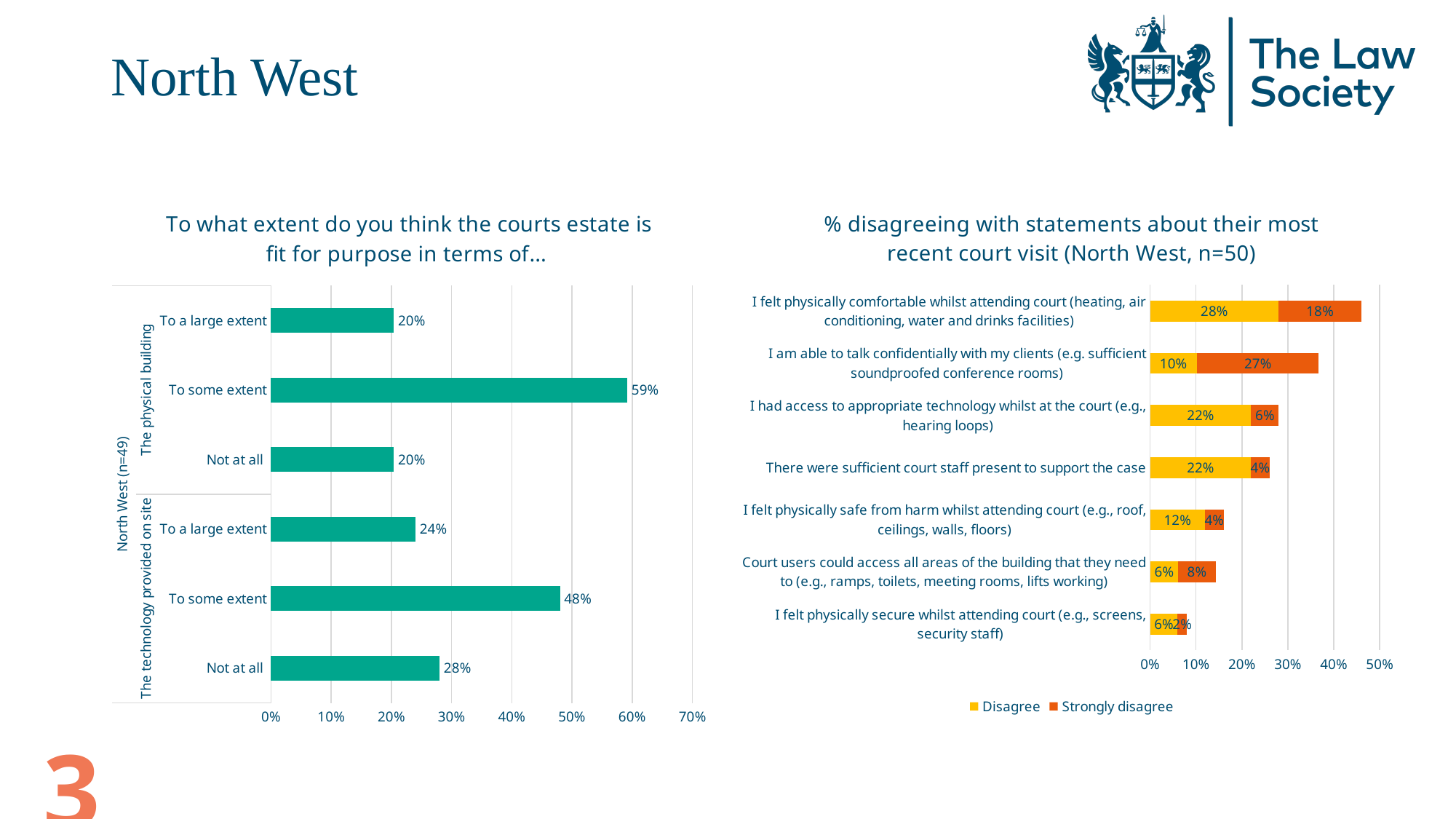
In the left chart 'To what extent do you think the courts estate is fit for purpose in terms of...', what is the value for 'Not at all' under 'The technology provided on site'? 28% What kind of chart is the left chart 'To what extent do you think the courts estate is fit for purpose in terms of...'? Bar chart In the left chart 'To what extent do you think the courts estate is fit for purpose in terms of...', how many bars are plotted? 6 In the right chart '% disagreeing with statements about their most recent court visit', what is the 'Strongly disagree' value for 'I am able to talk confidentially with my clients'? 27% In the left chart 'To what extent do you think the courts estate is fit for purpose in terms of...', what is the value for 'To some extent' under 'The physical building'? 59% In the right chart '% disagreeing with statements about their most recent court visit', is the 'Disagree' value larger for 'I had access to appropriate technology whilst at the court' or for 'I felt physically safe from harm whilst attending court'? I had access to appropriate technology whilst at the court In the right chart '% disagreeing with statements about their most recent court visit', what is the 'Disagree' value for 'I felt physically comfortable whilst attending court'? 28% In the left chart 'To what extent do you think the courts estate is fit for purpose in terms of...', what is the difference between 'To some extent' for the physical building and 'To some extent' for the technology provided on site? 11% In the right chart '% disagreeing with statements about their most recent court visit', what is the total of the stacked bar for 'I felt physically comfortable whilst attending court'? 46% In the right chart '% disagreeing with statements about their most recent court visit', how many series does the legend list? 2 In the right chart '% disagreeing with statements about their most recent court visit', which statement has the lowest 'Strongly disagree' value? I felt physically secure whilst attending court In the left chart 'To what extent do you think the courts estate is fit for purpose in terms of...', which category has the highest value? To some extent (The physical building)